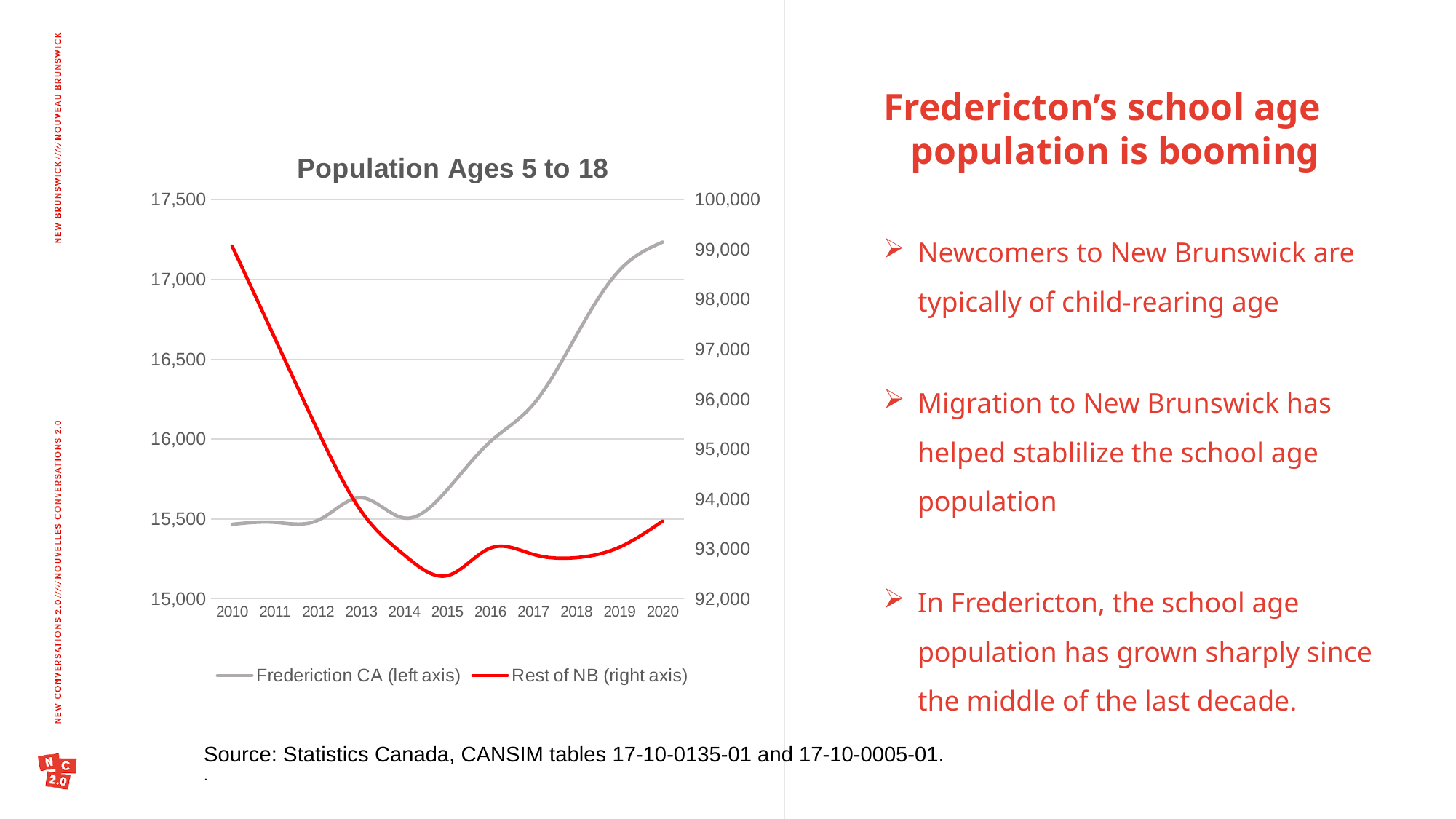
How many years are plotted along the x axis of the chart? 11 Is the Rest of NB value for 2015 greater or less than 93,000? less Does the Rest of NB series rise or fall between 2010 and 2015? fall In which year is the Frederiction CA series at its highest? 2020 How many series does the chart's legend list? 2 What kind of chart is shown on the slide? Line chart Is the Frederiction CA value for 2020 greater or less than 17,000? greater In which year is the Rest of NB series at its lowest? 2015 Which series is plotted against the right axis? Rest of NB Does the Frederiction CA series rise or fall between 2014 and 2020? rise What is the title of the chart? Population Ages 5 to 18 In which year is the Rest of NB series at its highest? 2010